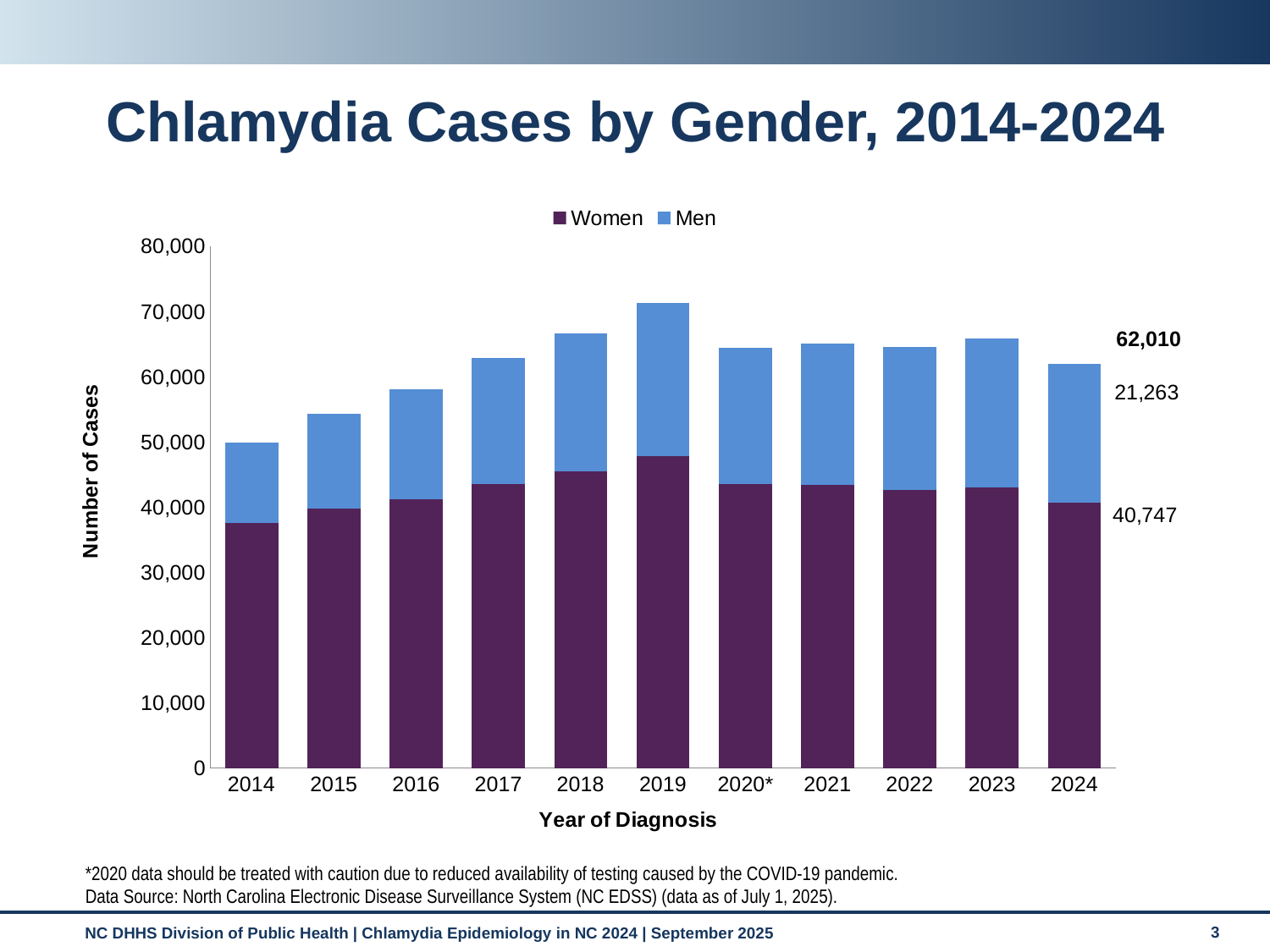
Which year has the highest total number of cases? 2019 Is the number of cases among women in 2014 greater or less than 40,000? less In 2024, how many more cases were there among women than among men? 19,484 Which year has the lowest total number of cases? 2014 How many series does the legend list? 2 Is the total number of cases in 2019 greater or less than 70,000? greater How many years are shown on the x axis? 11 How many chlamydia cases among men are shown for 2024? 21,263 What kind of chart is shown on the slide? bar chart Do total cases rise or fall from 2014 to 2019? rise How many chlamydia cases among women are shown for 2024? 40,747 What is the total number of chlamydia cases for 2024? 62,010